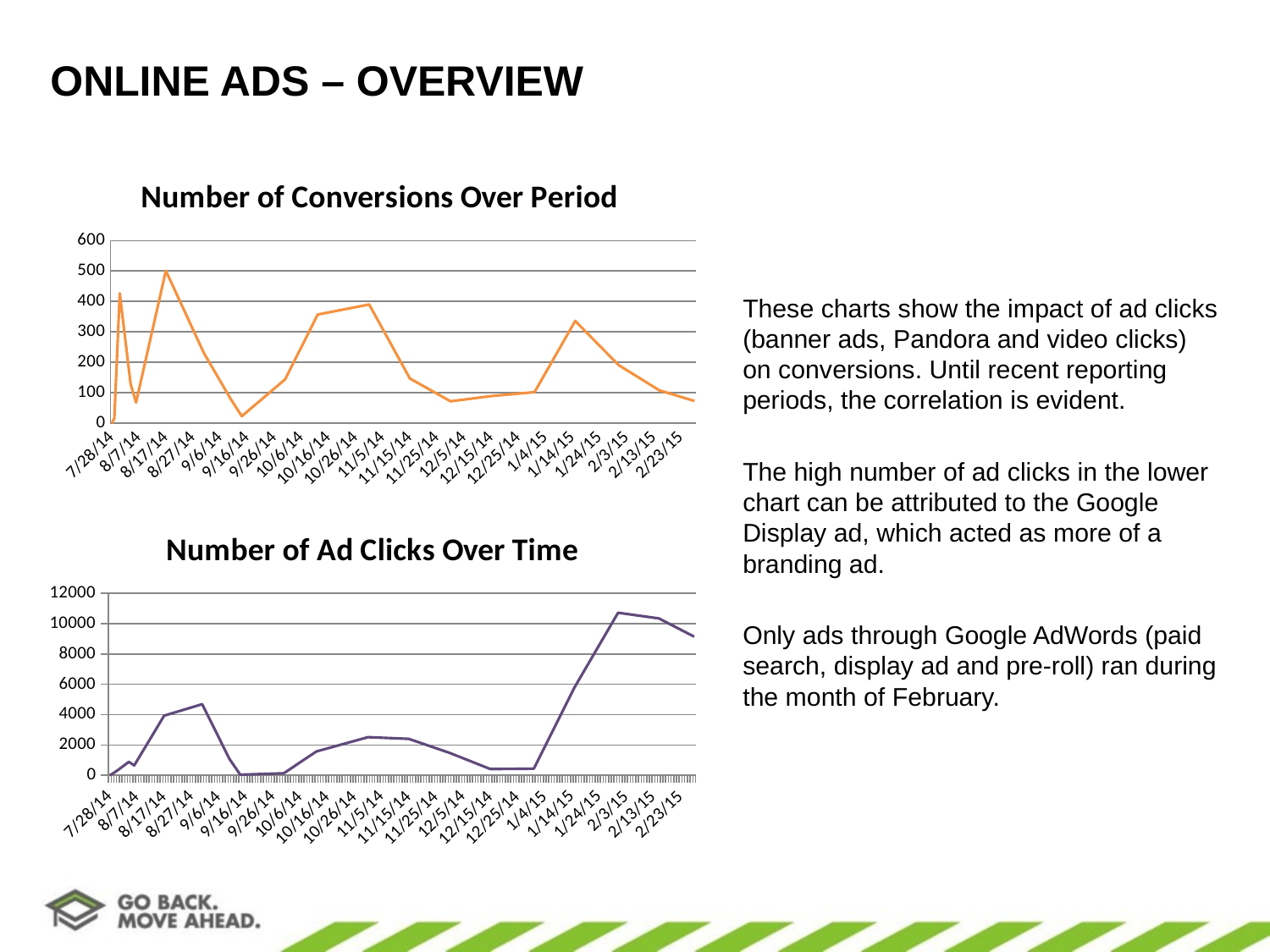
In the "Number of Conversions Over Period" chart, is the value for 10/26/14 greater or less than 300? greater In the "Number of Conversions Over Period" chart, which date has the highest number of conversions? 8/17/14 In the "Number of Ad Clicks Over Time" chart, which is larger, the value for 8/27/14 or the value for 2/3/15? 2/3/15 In the "Number of Ad Clicks Over Time" chart, is the value for 9/16/14 greater or less than 2000? less What kind of chart is "Number of Conversions Over Period"? line chart In the "Number of Conversions Over Period" chart, is the value for 9/16/14 greater or less than 100? less What kind of chart is "Number of Ad Clicks Over Time"? line chart What is the highest value shown on the y axis of the "Number of Ad Clicks Over Time" chart? 12000